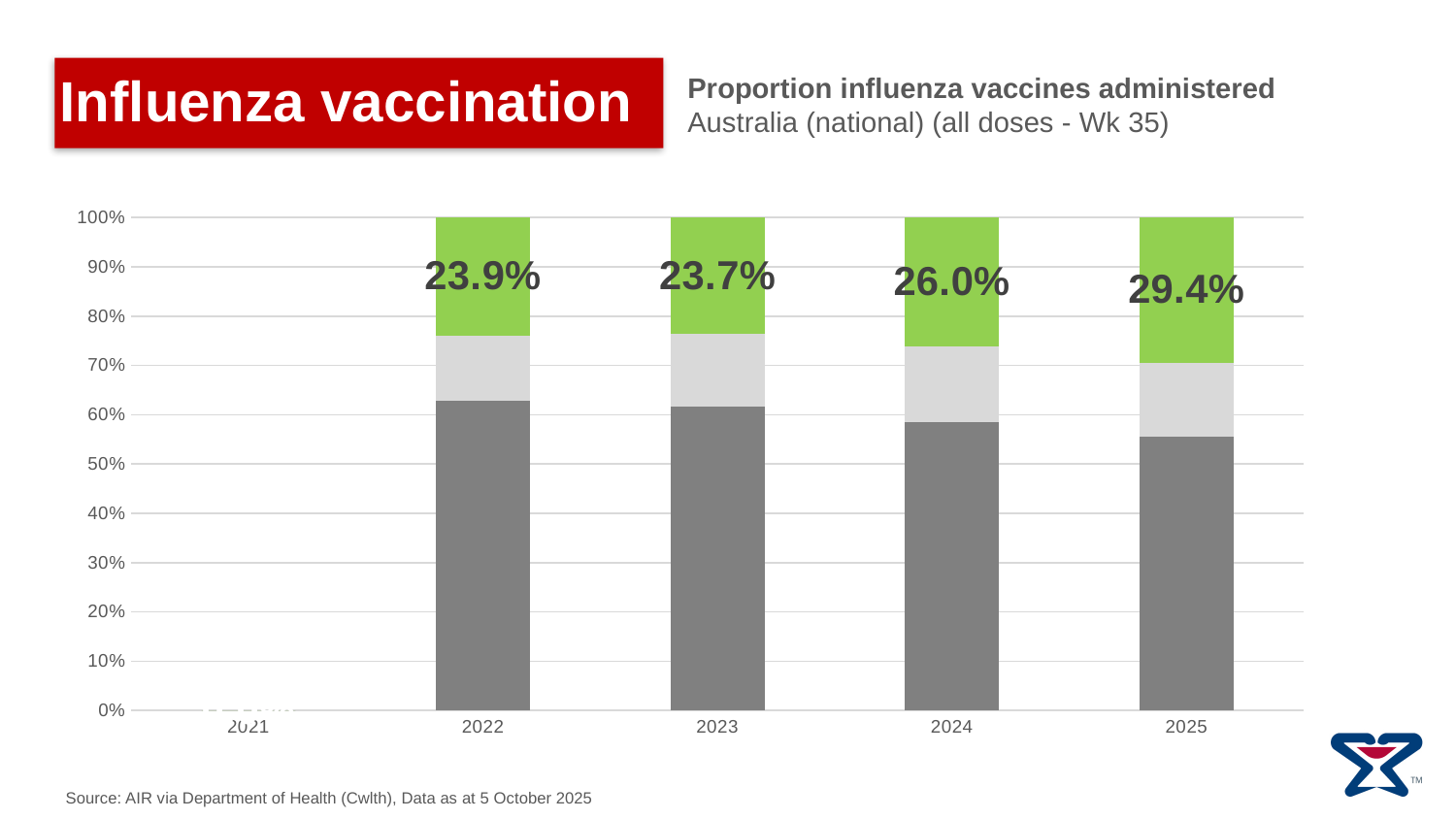
What is the difference between the labelled percentages for 2025 and 2022? 5.5% How many years are shown on the x axis? 5 What percentage is labelled on the 2024 bar? 26.0% What percentage is labelled on the 2022 bar? 23.9% From 2023 to 2025, do the labelled percentages rise or fall? rise Which year has the lowest labelled percentage? 2023 Which year has the highest labelled percentage? 2025 Is the top of the dark grey segment for 2025 greater or less than 60%? less What percentage is labelled on the 2025 bar? 29.4% What kind of chart is shown on the slide? Stacked bar chart What percentage is labelled on the 2023 bar? 23.7% Is the labelled percentage for 2024 larger than that for 2022? Yes, 2024 (26.0%) is larger